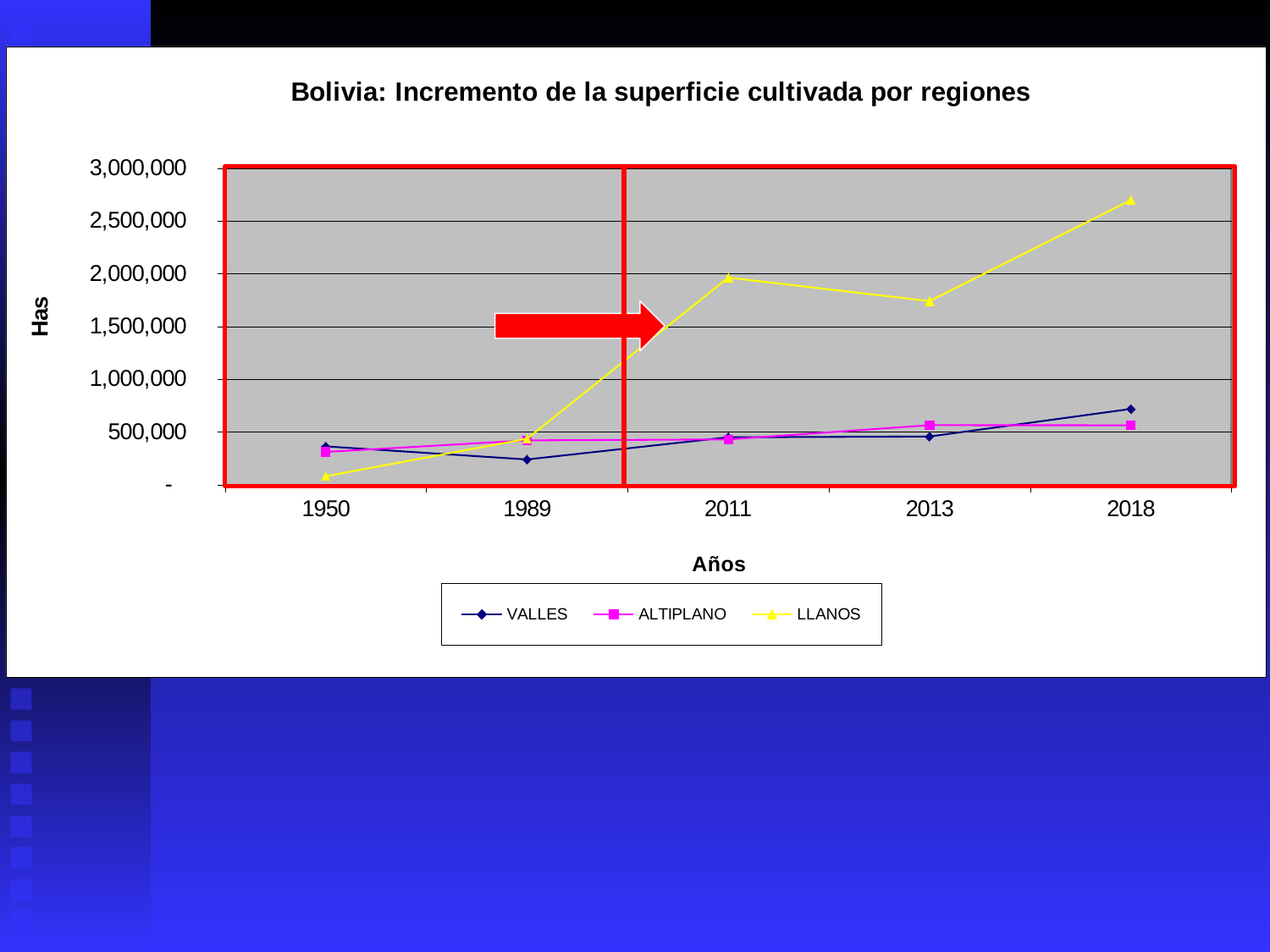
Which series has the highest value in 2018? LLANOS What is the title of the chart? Bolivia: Incremento de la superficie cultivada por regiones What kind of chart is shown on the slide? line chart Does the LLANOS series rise or fall between 1989 and 2011? rise Which series has the lowest value in 1950? LLANOS Is the value for LLANOS in 2013 greater or less than 2,000,000? less Is the value for LLANOS in 1950 greater or less than 500,000? less How many years are shown on the x axis? 5 Is the value for LLANOS in 2018 greater or less than 2,500,000? greater How many series does the legend list? 3 Which is larger in 2018, the value for LLANOS or the value for ALTIPLANO? LLANOS